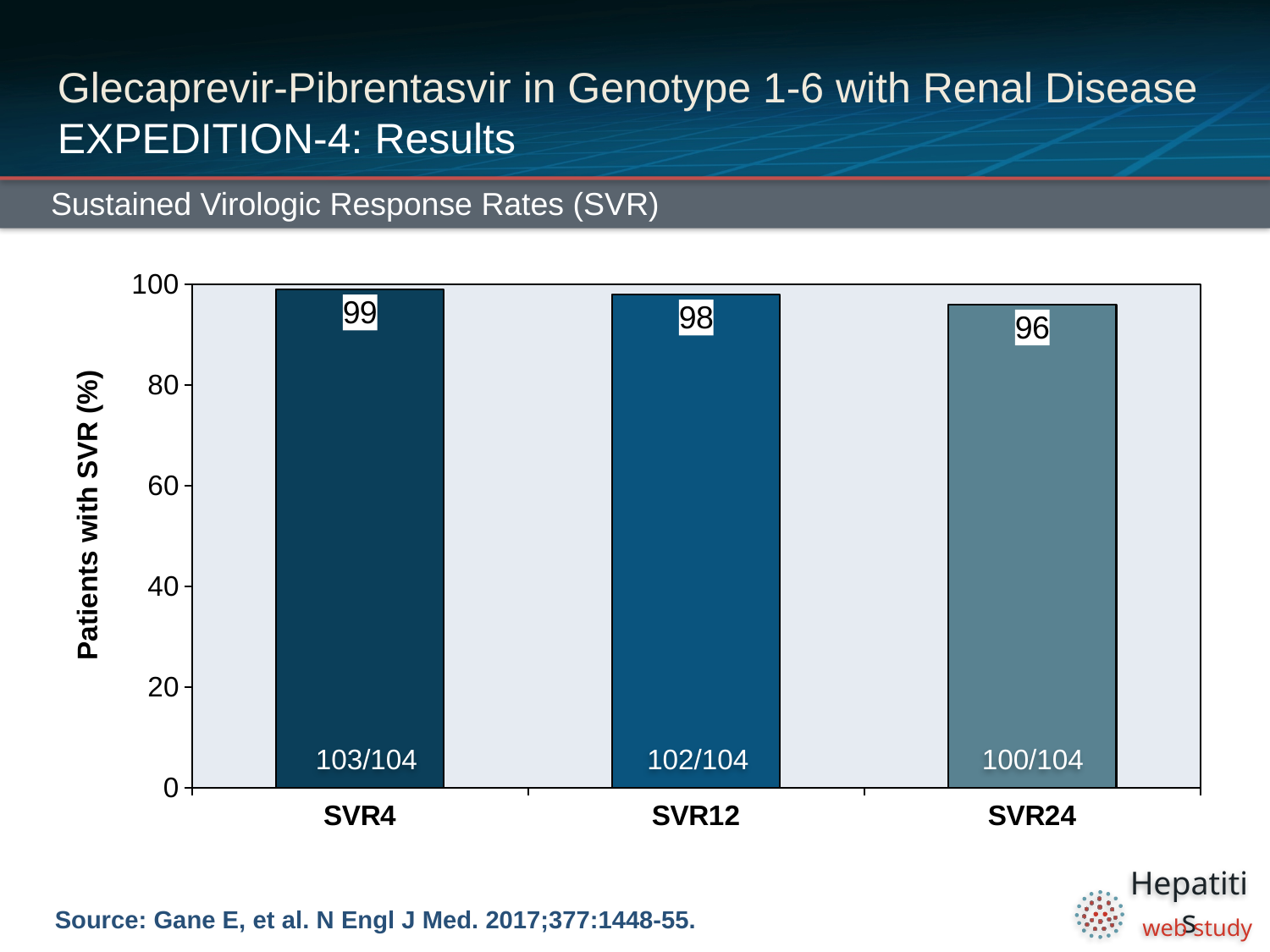
What fraction of patients is shown for the SVR4 bar? 103/104 Which has a higher SVR rate, SVR12 or SVR24? SVR12 Do the SVR rates rise or fall from SVR4 to SVR24? Fall What kind of chart is shown on the slide? Bar chart What is the SVR rate (%) for SVR4? 99 How many categories are shown on the x axis? 3 What is the SVR rate (%) for SVR24? 96 What fraction of patients is shown for the SVR24 bar? 100/104 Which category has the lowest SVR rate? SVR24 Which category has the highest SVR rate? SVR4 What is the SVR rate (%) for SVR12? 98 What is the difference in SVR rate between SVR4 and SVR24? 3